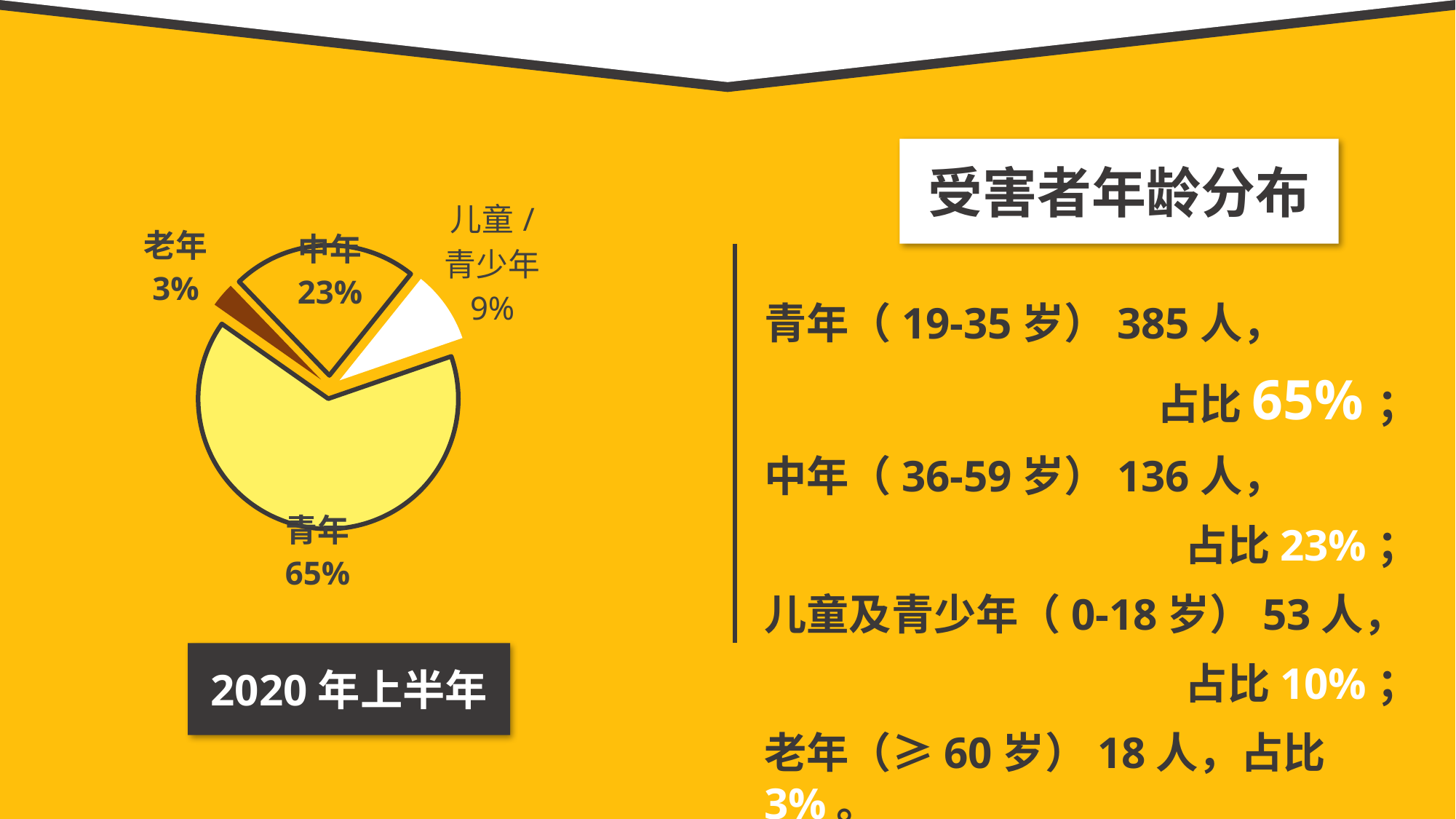
What share of the pie does 中年 account for? 23% What share of the pie does 青年 account for? 65% How many slices does the pie chart have? 4 What share of the pie does 老年 account for? 3% What is the difference in percentage points between the 青年 slice and the 中年 slice? 42 What is the difference in percentage points between the 儿童/青少年 slice and the 老年 slice? 6 What time period does the label below the pie chart indicate? 2020 年上半年 What kind of chart is shown on the slide? pie chart Which slice is larger, 中年 or 儿童/青少年? 中年 Which category has the smallest slice of the pie? 老年 What share of the pie does 儿童/青少年 account for? 9% Which category has the largest slice of the pie? 青年